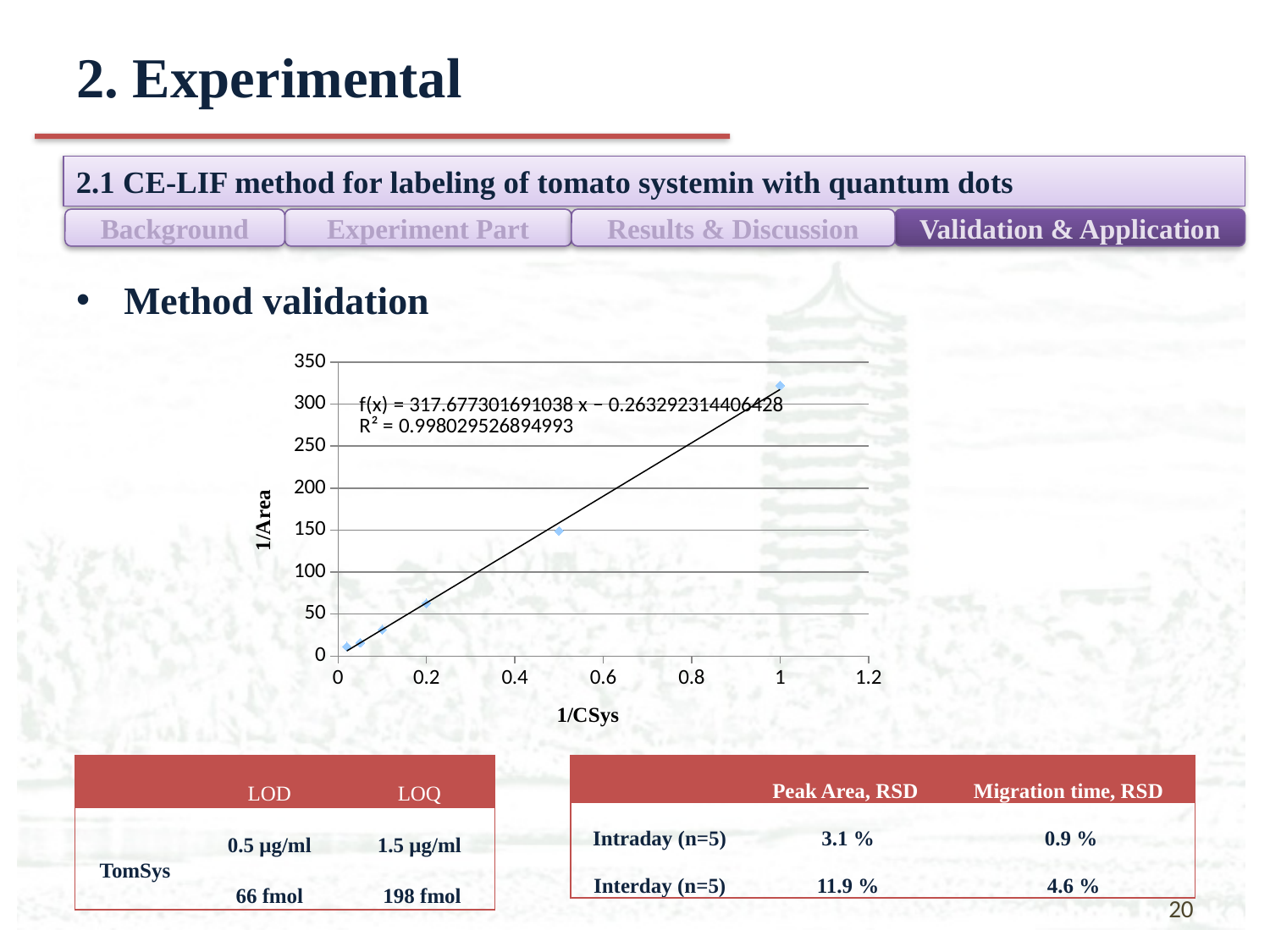
What is the slope in the trendline equation printed on the chart? 317.677301691038 Is the 1/Area value of the point at 1/CSys = 1 greater or less than 300? greater What is the intercept in the trendline equation printed on the chart? −0.263292314406428 What is the title of the y axis of the chart? 1/Area What kind of chart is shown on the slide? scatter chart What R² value is printed on the chart? 0.998029526894993 Is the 1/Area value of the point at 1/CSys = 0.2 greater or less than 100? less How many data points are plotted on the chart? 6 What is the highest tick value shown on the y axis of the chart? 350 Is the 1/Area value of the point at 1/CSys = 0.5 greater or less than 100? greater Do the plotted values rise or fall as 1/CSys increases? rise What is the title of the x axis of the chart? 1/CSys